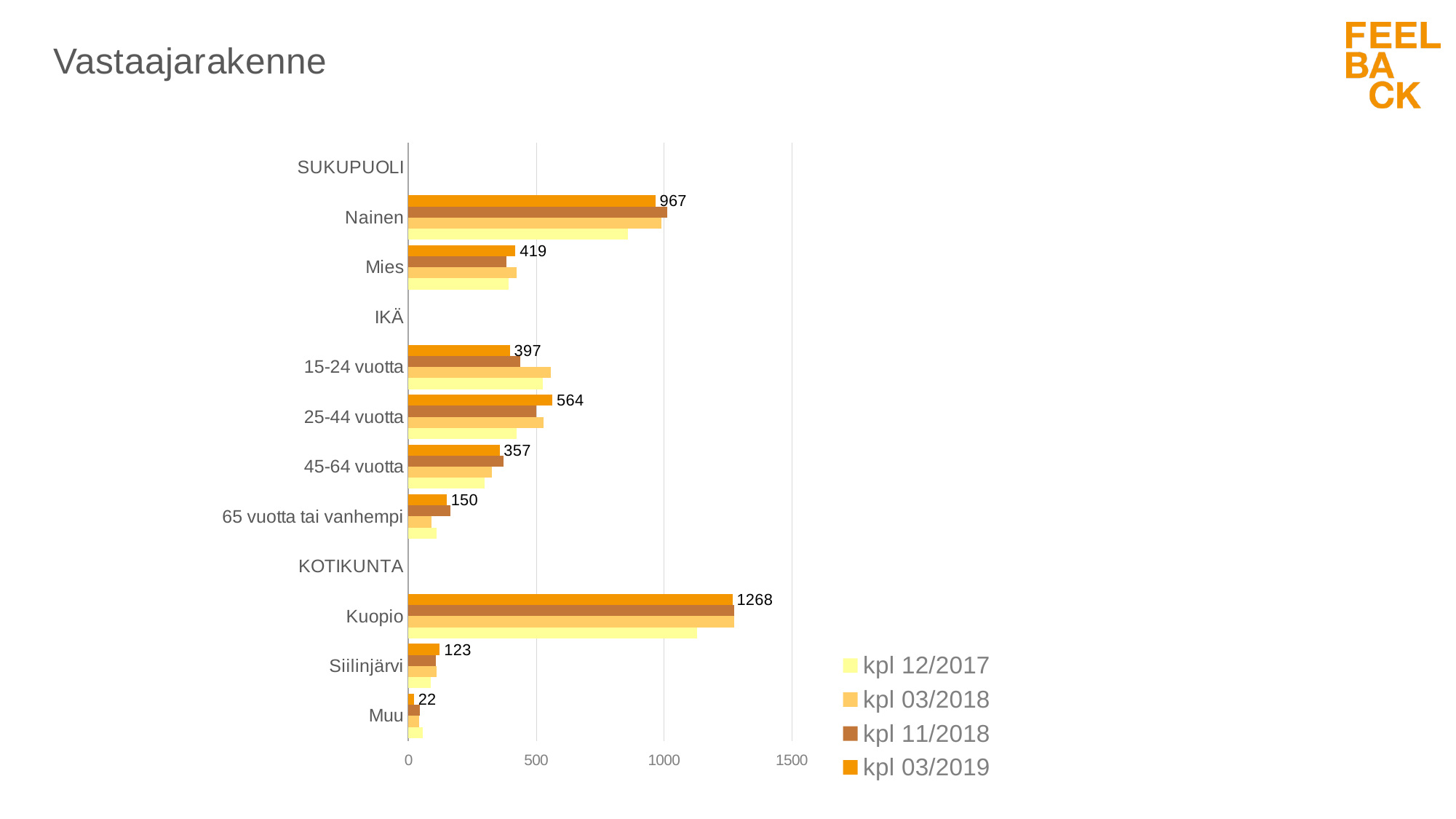
Which has a larger kpl 03/2019 value, 15-24 vuotta or 45-64 vuotta? 15-24 vuotta What is the kpl 03/2019 value for Nainen? 967 What is the difference between the kpl 03/2019 values for Nainen and Mies? 548 Which age group has the highest kpl 03/2019 value? 25-44 vuotta Is the kpl 12/2017 value for Kuopio greater or less than 1000? greater What is the kpl 03/2019 value for Kuopio? 1268 What is the kpl 03/2019 value for Siilinjärvi? 123 Which home municipality category has the lowest kpl 03/2019 value? Muu What is the kpl 03/2019 value for 65 vuotta tai vanhempi? 150 Is the kpl 12/2017 value for Nainen greater or less than 1000? less How many series does the legend list? 4 What kind of chart is shown on the slide? Bar chart